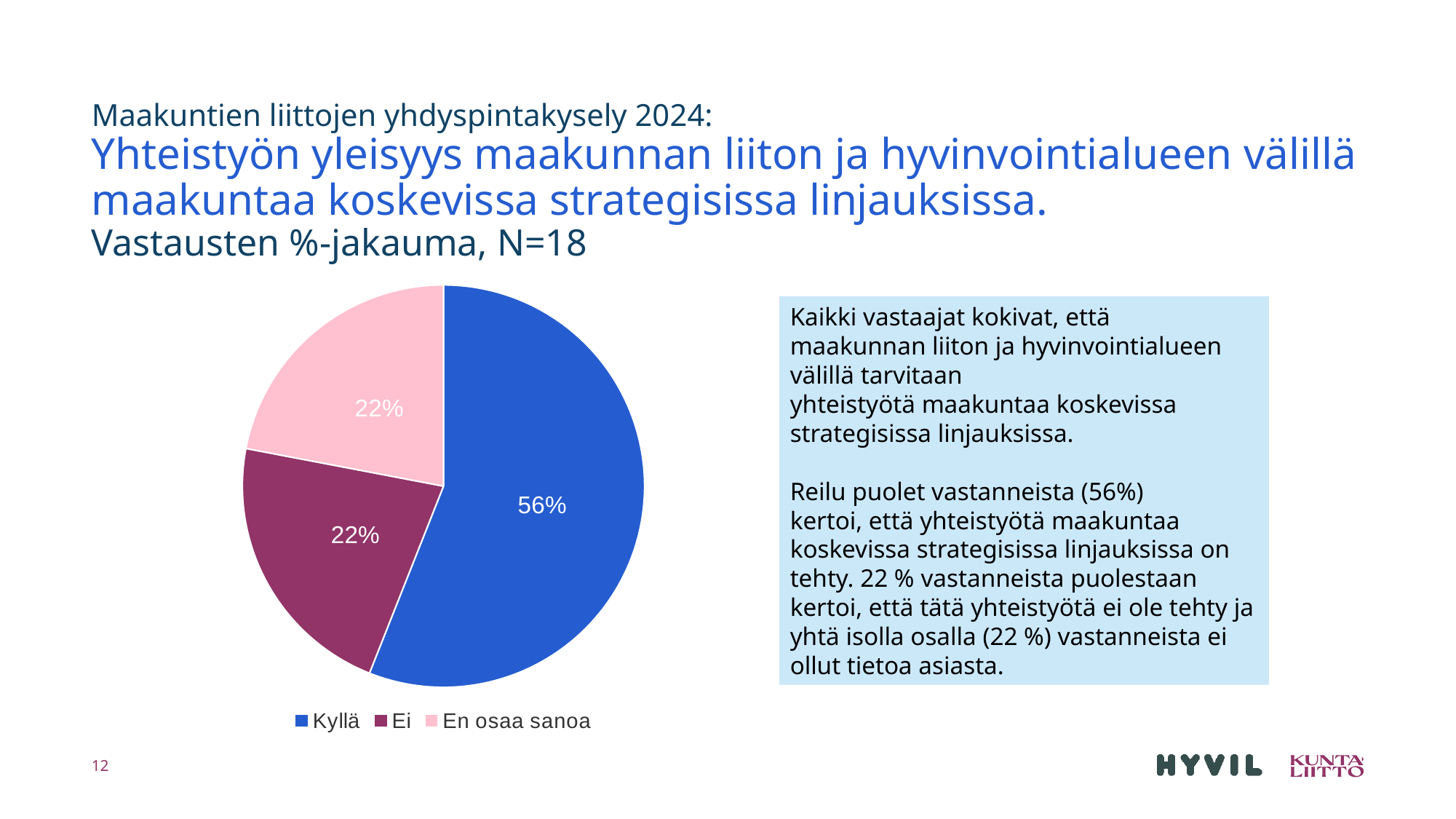
What share of responses is 'En osaa sanoa'? 22% What kind of chart is shown on the slide? pie chart Which category has the largest slice of the pie? Kyllä What is the difference between the 'Kyllä' share and the 'Ei' share? 34 percentage points Is the 'Kyllä' share greater or less than 50%? greater What colour is the 'Ei' slice in the pie chart? dark magenta/purple How many slices does the pie chart have? 3 What share of responses is 'Kyllä'? 56% What share of responses is 'Ei'? 22% Which is larger, the 'Kyllä' slice or the 'En osaa sanoa' slice? Kyllä How many entries does the legend list? 3 What is the N (number of respondents) stated in the chart subtitle? 18